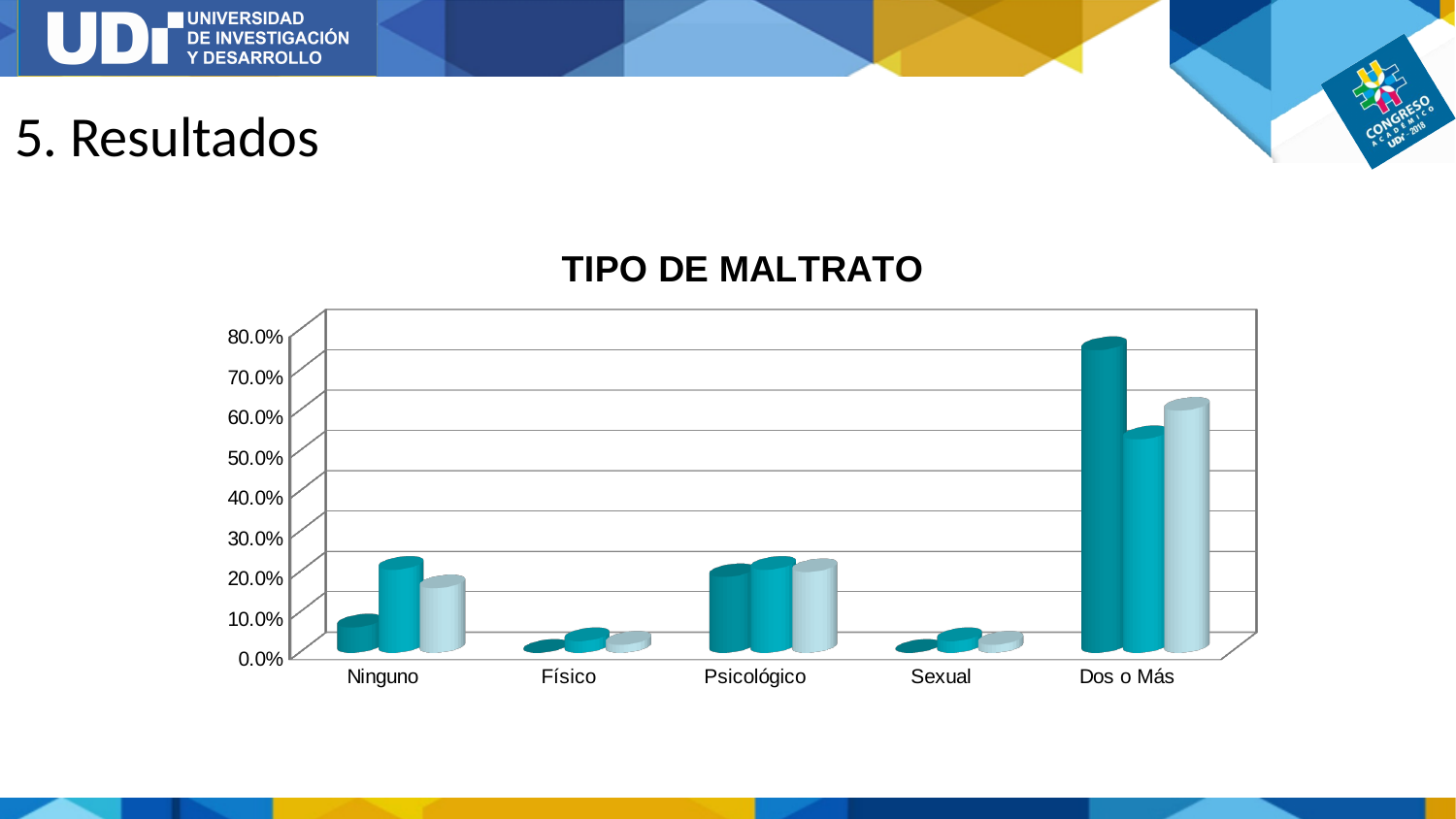
What is the title of the chart? TIPO DE MALTRATO Is the value of the dark teal bar for Dos o Más greater or less than 70.0%? greater Is the value of the medium teal bar for Dos o Más greater or less than 60.0%? less Is the value of the light blue bar for Dos o Más greater or less than 50.0%? greater Which is larger for Dos o Más, the dark teal bar or the light blue bar? the dark teal bar How many bars are plotted for each category in the chart? 3 How many categories are shown on the x axis of the chart? 5 Which is larger, the dark teal bar for Ninguno or the dark teal bar for Psicológico? Psicológico What kind of chart is shown on the slide? bar chart Which category has the highest bars in the chart? Dos o Más